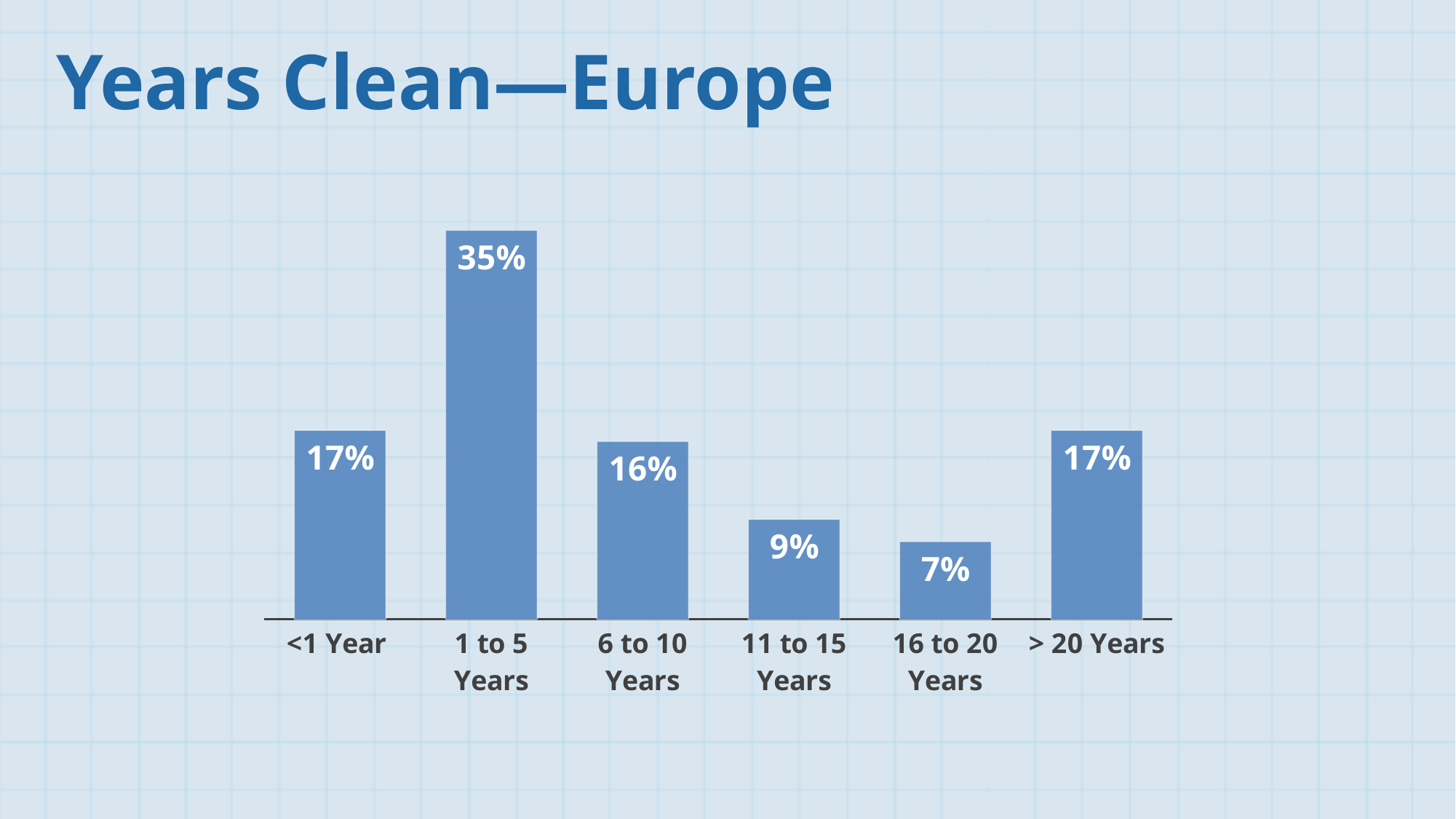
What kind of chart is shown on the slide? Bar chart Which category has the highest value? 1 to 5 Years What is the difference between the values for 1 to 5 Years and 6 to 10 Years? 19% What is the value for the 1 to 5 Years category? 35% Which is larger, the value for 6 to 10 Years or the value for 11 to 15 Years? 6 to 10 Years What is the difference between the values for 11 to 15 Years and 16 to 20 Years? 2% What is the title of the slide? Years Clean—Europe What is the value for the 6 to 10 Years category? 16% What is the value for the 11 to 15 Years category? 9% Which category has the lowest value? 16 to 20 Years What is the value for the 16 to 20 Years category? 7% How many categories are shown on the x axis? 6